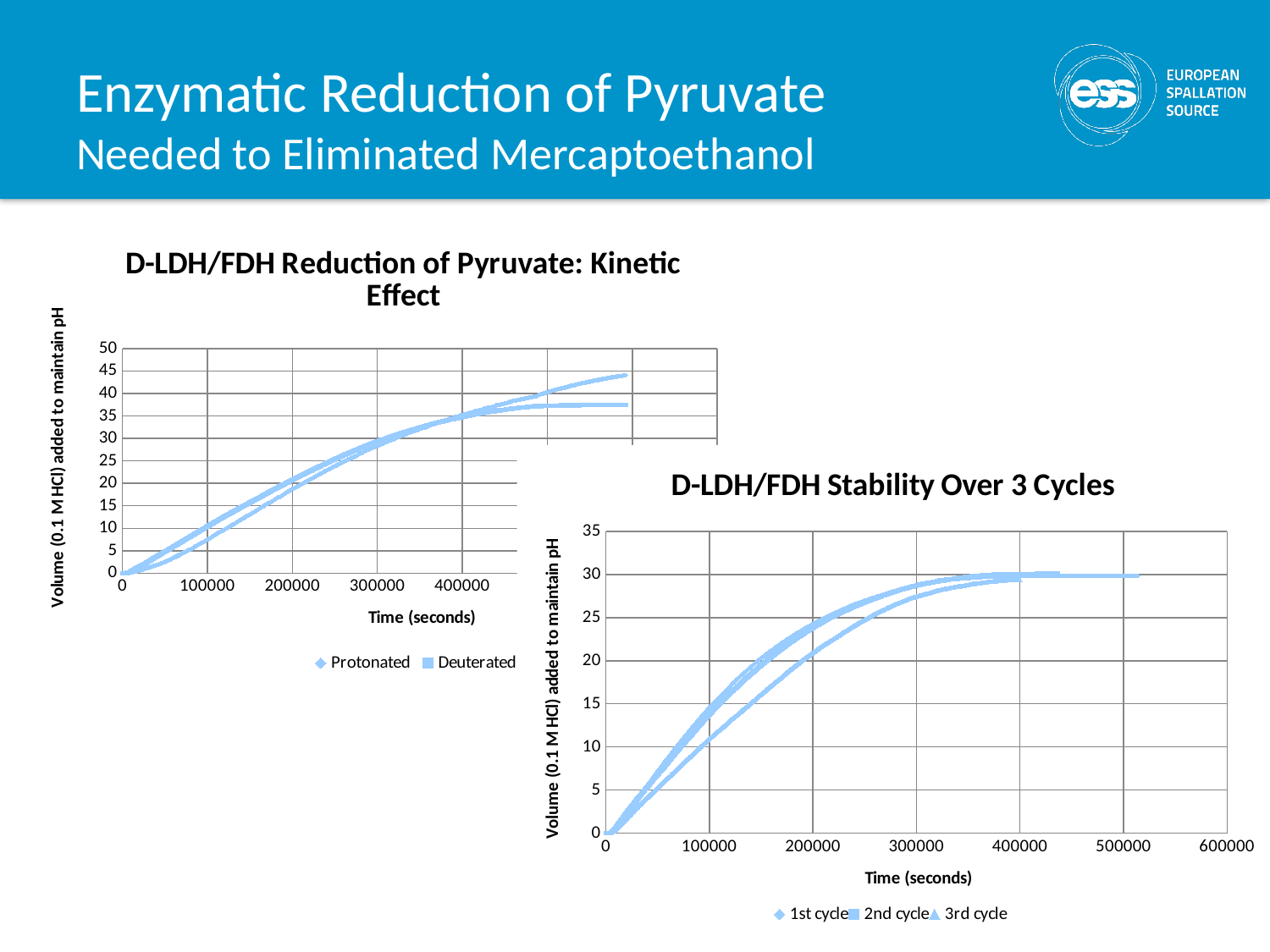
In the 'D-LDH/FDH Stability Over 3 Cycles' chart, is the value at 500000 seconds greater or less than 35? less In the 'D-LDH/FDH Reduction of Pyruvate: Kinetic Effect' chart, how many series does the legend list? 2 In the 'D-LDH/FDH Stability Over 3 Cycles' chart, do the plotted values rise or fall as time increases? rise In the 'D-LDH/FDH Stability Over 3 Cycles' chart, what is the label of the x axis? Time (seconds) In the 'D-LDH/FDH Reduction of Pyruvate: Kinetic Effect' chart, are the values at 100000 seconds greater or less than 10? less In the 'D-LDH/FDH Reduction of Pyruvate: Kinetic Effect' chart, do the plotted values rise or fall as time increases? rise In the 'D-LDH/FDH Stability Over 3 Cycles' chart, is the value at 500000 seconds greater or less than 25? greater In the 'D-LDH/FDH Reduction of Pyruvate: Kinetic Effect' chart, what are the two series named in the legend? Protonated and Deuterated Which chart on the slide has more series in its legend, the 'Kinetic Effect' chart or the 'Stability Over 3 Cycles' chart? D-LDH/FDH Stability Over 3 Cycles In the 'D-LDH/FDH Stability Over 3 Cycles' chart, how many series does the legend list? 3